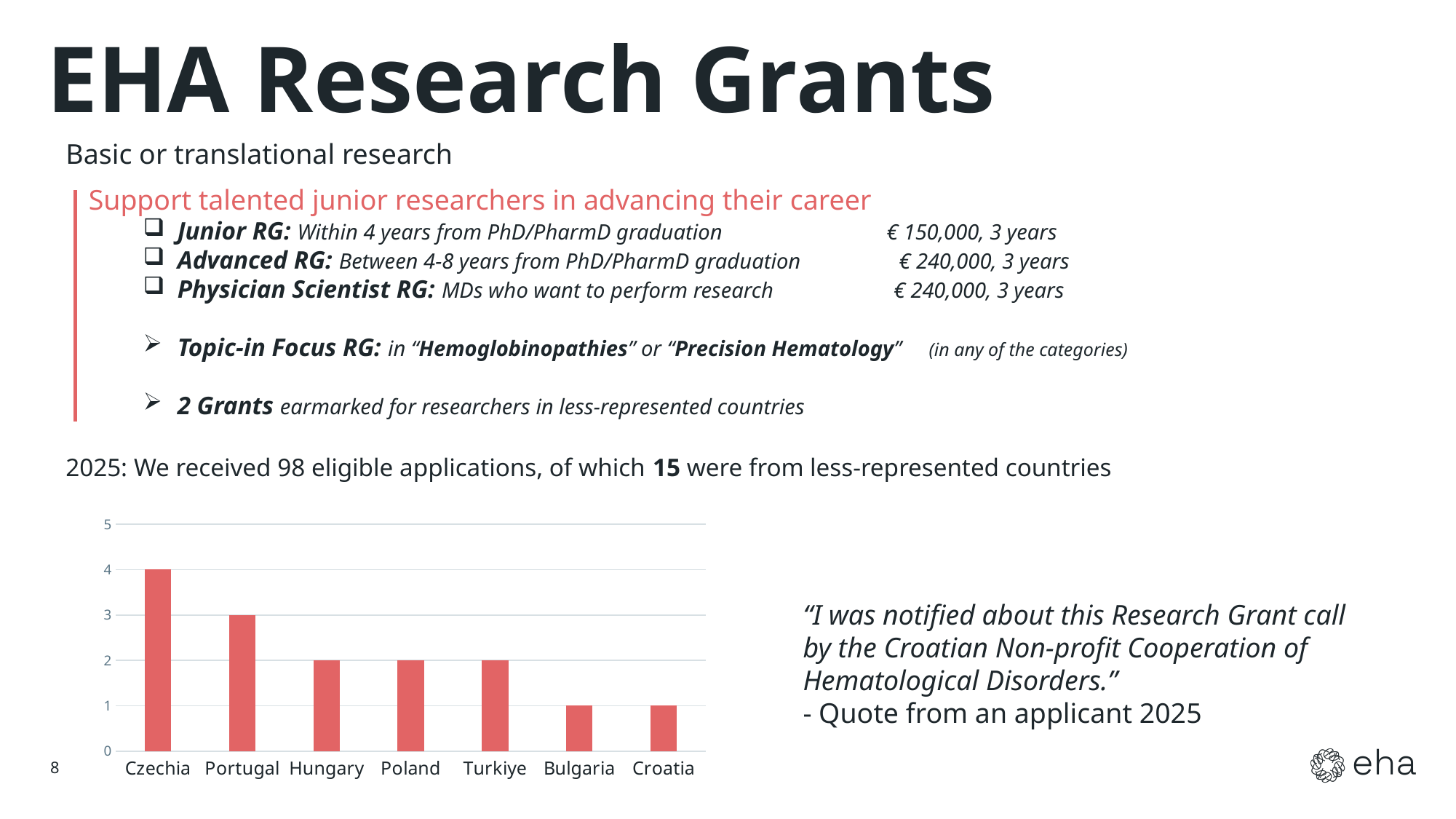
What type of chart is shown on the slide? bar chart What is the value for Czechia in the bar chart? 4 How many countries are shown on the x axis of the bar chart? 7 Which country has the highest bar in the chart? Czechia Do the bar values generally rise or fall from left to right along the x axis? fall What is the difference between the values for Portugal and Bulgaria? 2 What is the value for Croatia in the bar chart? 1 What is the value for Hungary in the bar chart? 2 What is the highest value shown on the y axis of the bar chart? 5 Which is larger, the value for Portugal or the value for Turkiye? Portugal What is the value for Portugal in the bar chart? 3 What is the difference between the values for Czechia and Croatia? 3